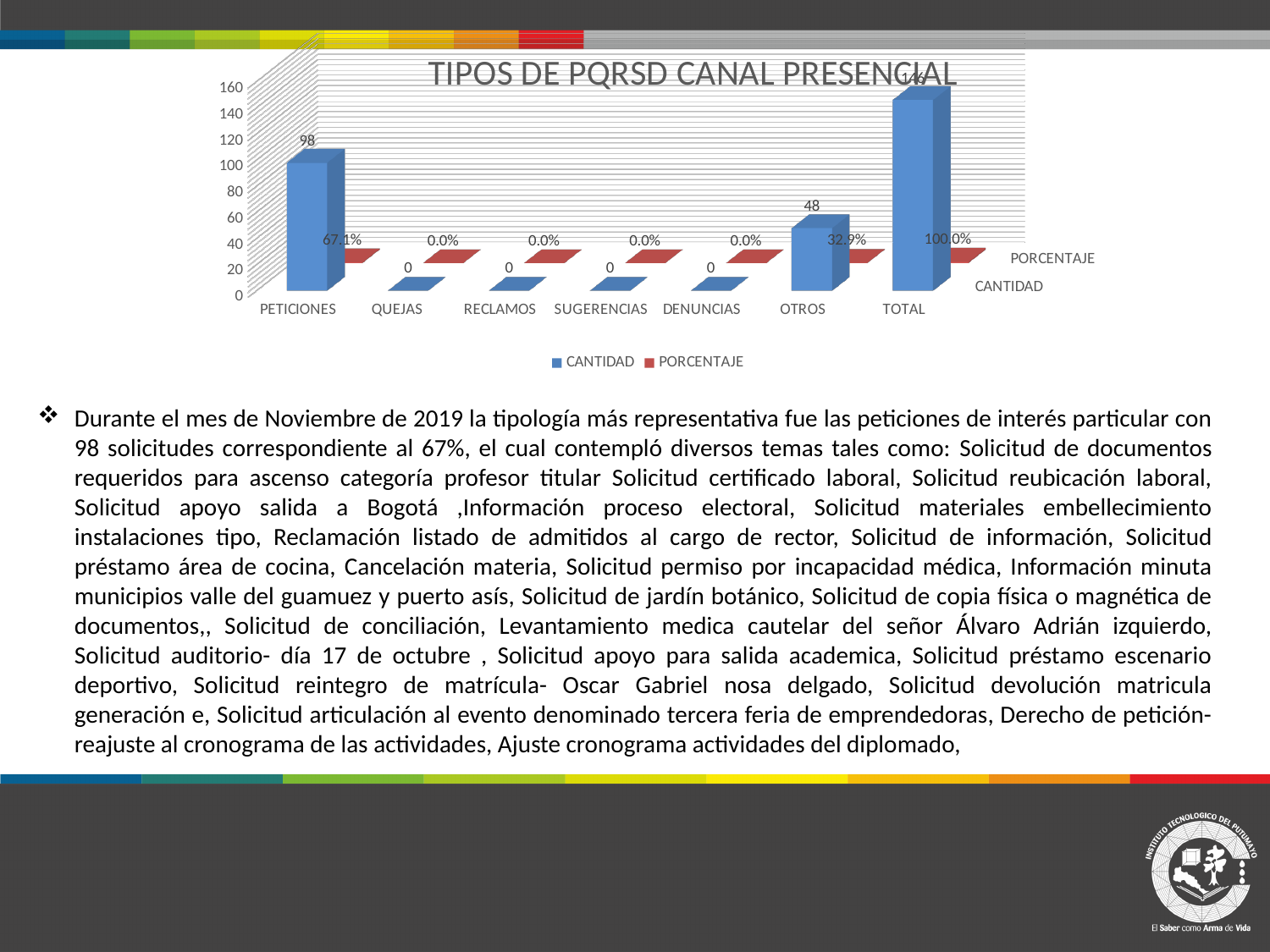
What is the difference between the CANTIDAD values for PETICIONES and OTROS? 50 How many categories are shown on the x axis of the chart? 7 Which category has the highest CANTIDAD value? TOTAL How many series does the chart legend list? 2 What is the title of the chart? TIPOS DE PQRSD CANAL PRESENCIAL What is the CANTIDAD value for QUEJAS? 0 What type of chart is shown on the slide? bar chart What is the PORCENTAJE value for OTROS? 32.9% What is the PORCENTAJE value for PETICIONES? 67.1% What is the CANTIDAD value for PETICIONES? 98 What is the CANTIDAD value for OTROS? 48 What is the PORCENTAJE value for TOTAL? 100.0%